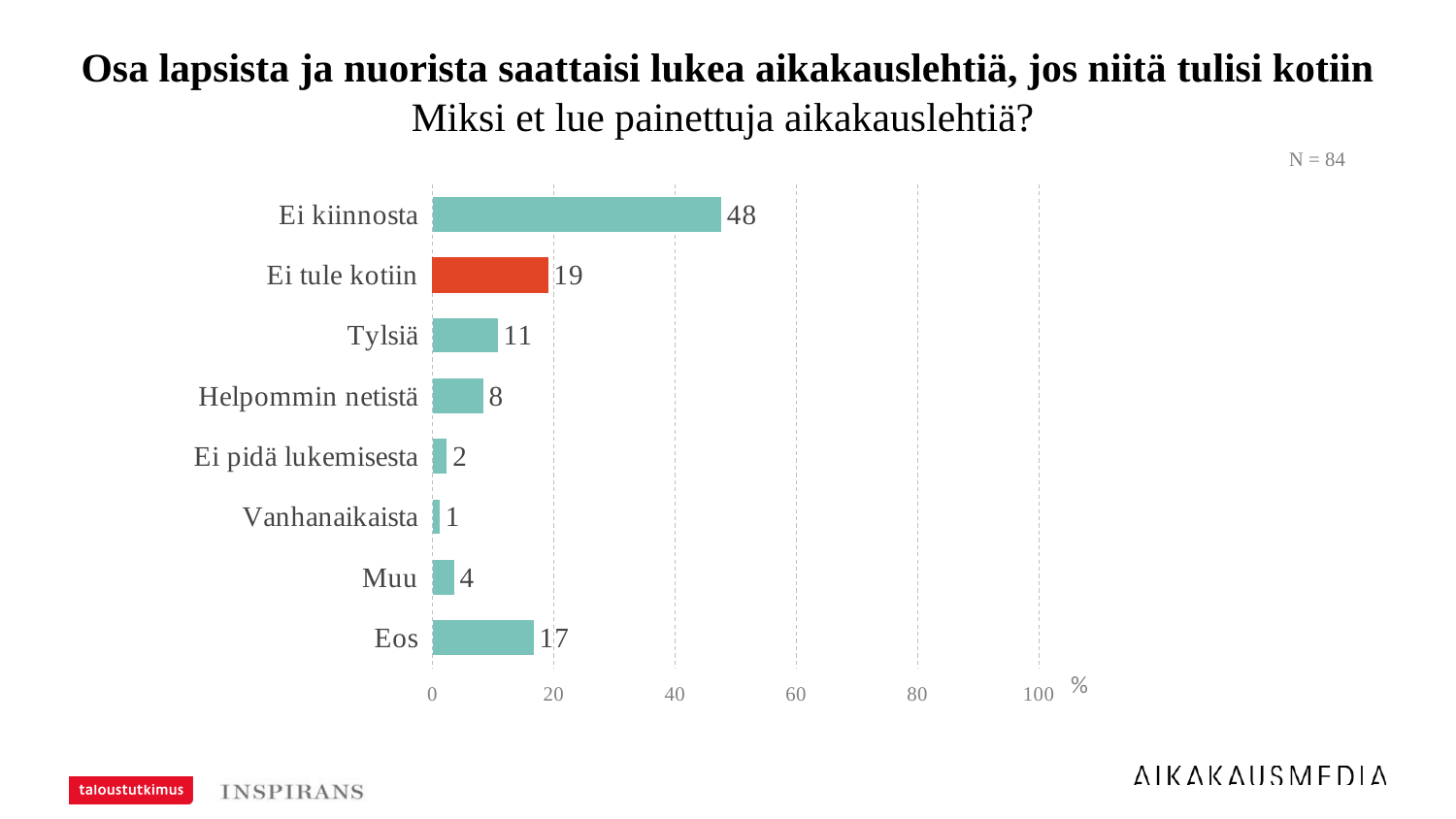
Which is larger, the value for "Tylsiä" or the value for "Helpommin netistä"? Tylsiä What is the sample size (N) shown on the slide? N = 84 What is the value for "Eos"? 17 What is the difference between the values for "Ei kiinnosta" and "Ei tule kotiin"? 29 What kind of chart is shown on the slide? bar chart Is the value for "Ei kiinnosta" greater or less than 40? greater Which bar is coloured differently (red) from the others? Ei tule kotiin Which category has the lowest value? Vanhanaikaista What is the value for "Ei kiinnosta"? 48 What is the value for "Ei tule kotiin"? 19 Which category has the highest value? Ei kiinnosta How many categories are shown in the chart? 8